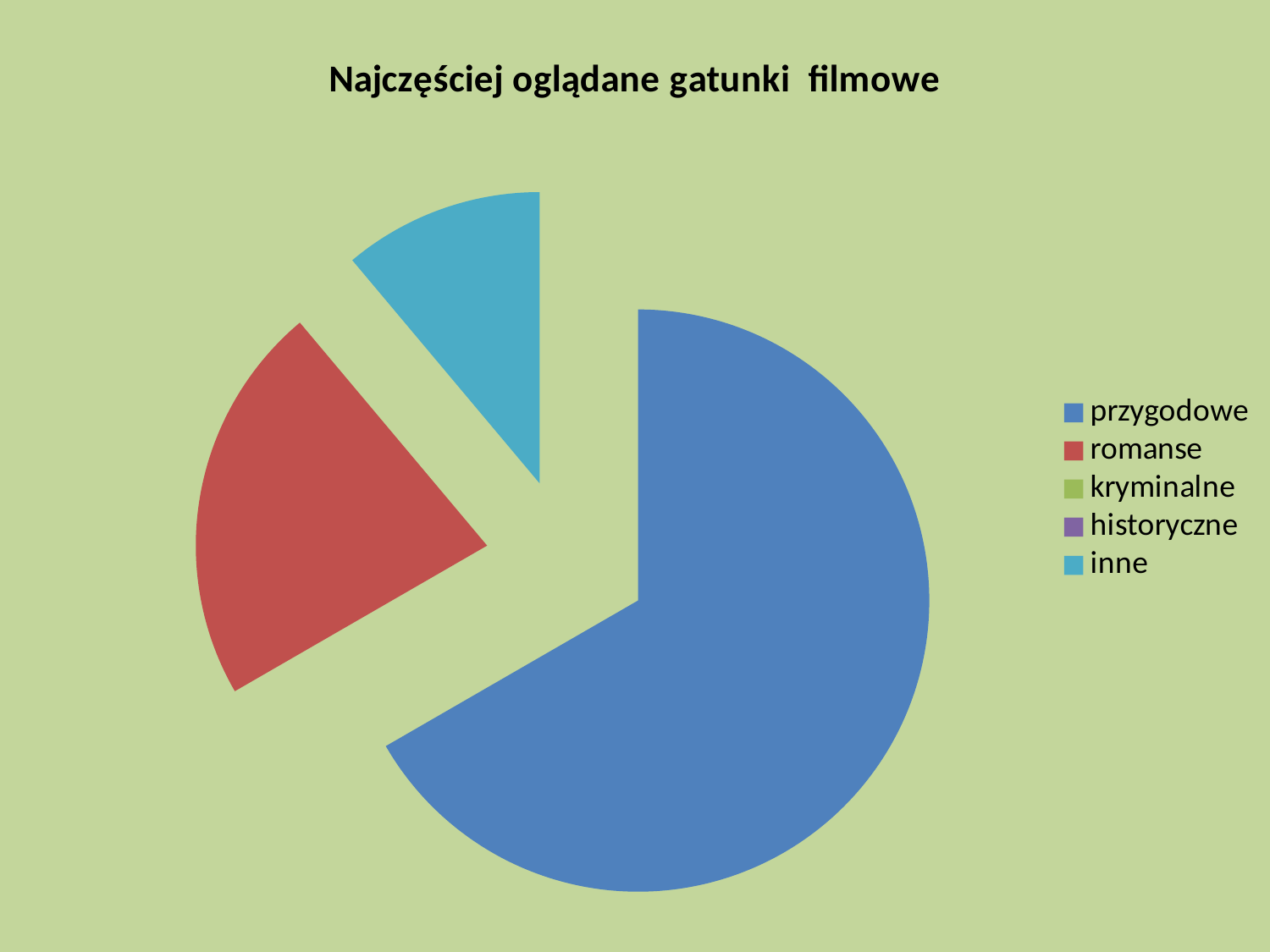
Which category is listed second in the legend? romanse How many categories does the legend list? 5 Which slice is larger, przygodowe or romanse? przygodowe What colour is the slice for przygodowe? blue Which slice is larger, inne or przygodowe? przygodowe Does the przygodowe slice make up more or less than half of the pie? more than half What is the title of the chart? Najczęściej oglądane gatunki filmowe Which category has the largest slice of the pie? przygodowe What kind of chart is shown on the slide? pie chart